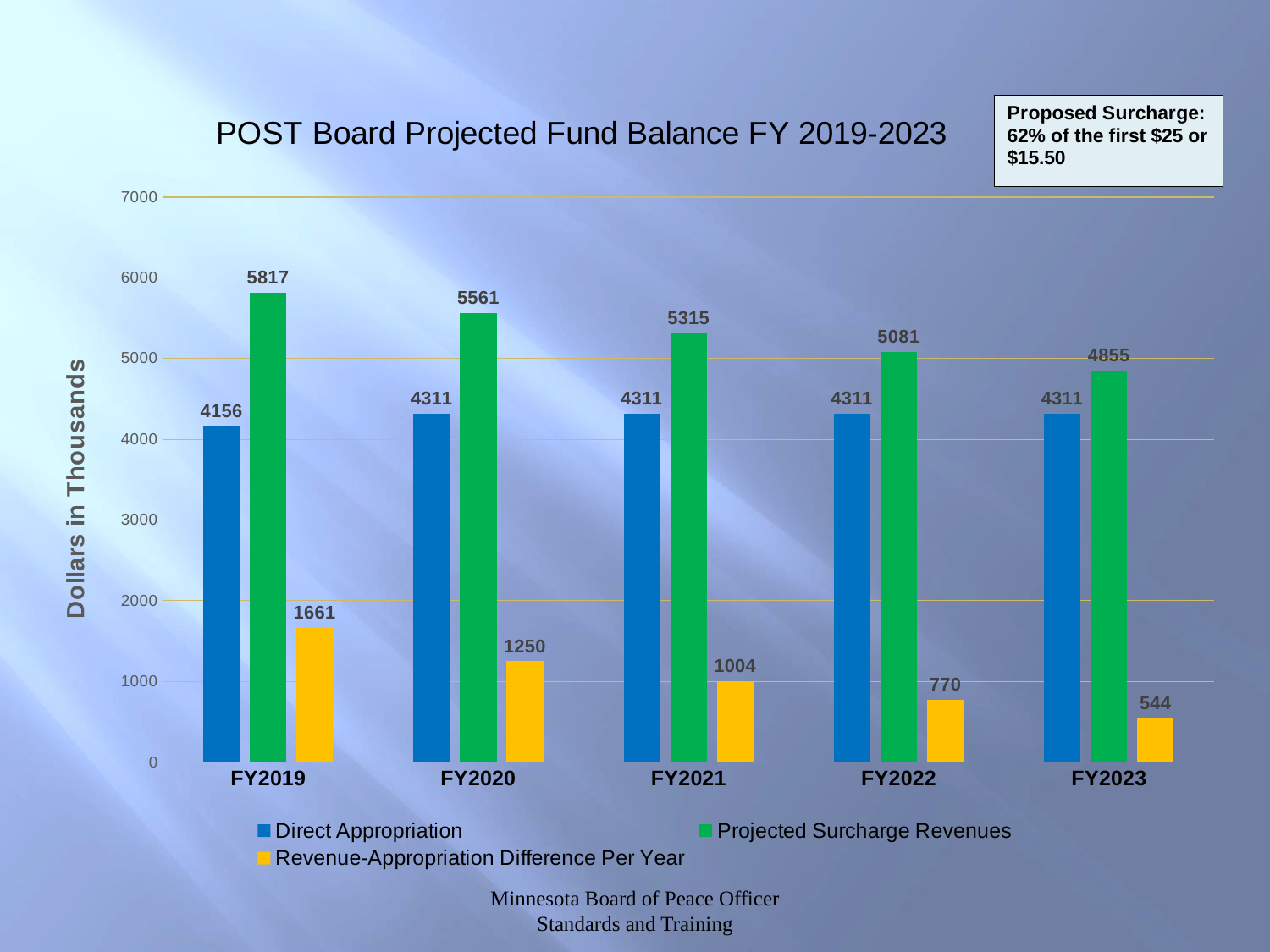
What is the Revenue-Appropriation Difference Per Year value for FY2022? 770 What is the Projected Surcharge Revenues value for FY2019? 5817 How many series does the legend list? 3 What is the difference between Projected Surcharge Revenues and Direct Appropriation in FY2020? 1250 What kind of chart is shown on the slide? Bar chart Do the Projected Surcharge Revenues values rise or fall from FY2019 to FY2023? Fall Which is larger in FY2023: Direct Appropriation or Projected Surcharge Revenues? Projected Surcharge Revenues Which fiscal year has the lowest Revenue-Appropriation Difference Per Year? FY2023 What is the Direct Appropriation value for FY2021? 4311 Is the Direct Appropriation value for FY2019 greater or less than 4000? greater Which fiscal year has the highest Projected Surcharge Revenues? FY2019 How many fiscal years are shown on the x axis? 5